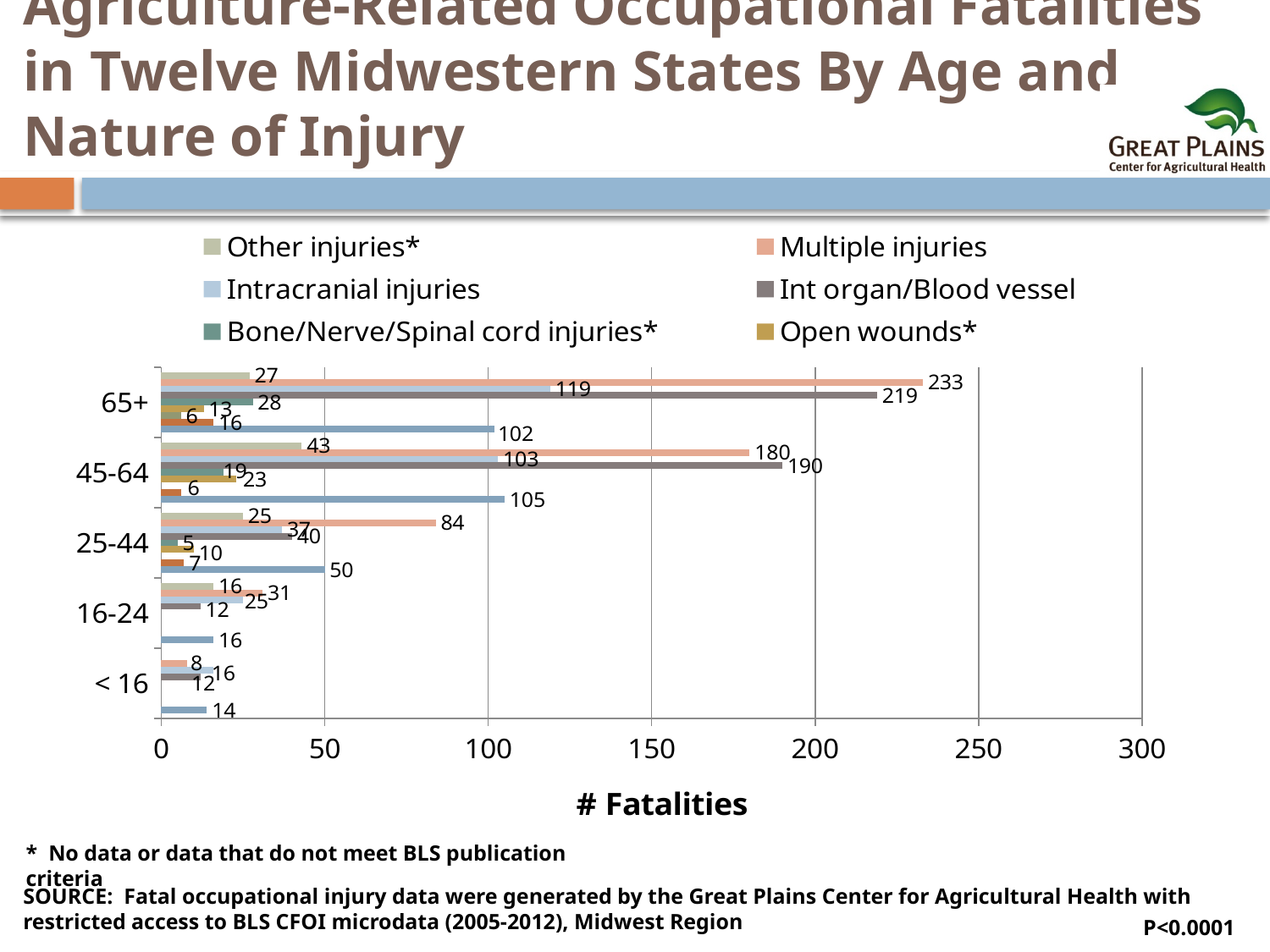
How many fatalities from Multiple injuries are shown for the 25-44 age group? 84 Which age group has the highest number of fatalities from Multiple injuries? 65+ What is the value for Other injuries* in the 45-64 age group? 43 What is the title of the x axis? # Fatalities What is the difference between the Multiple injuries value (233) and the Int organ/Blood vessel value (219) for the 65+ age group? 14 How many age groups are shown on the y axis of the chart? 5 Do the Multiple injuries values rise or fall as age group increases from < 16 to 65+? rise How many series does the chart's legend list? 6 What kind of chart is shown on the slide? bar chart Which is larger for the 45-64 age group: Multiple injuries or Int organ/Blood vessel? Int organ/Blood vessel How many fatalities from Multiple injuries are shown for the 65+ age group? 233 What is the value for Int organ/Blood vessel in the 65+ age group? 219